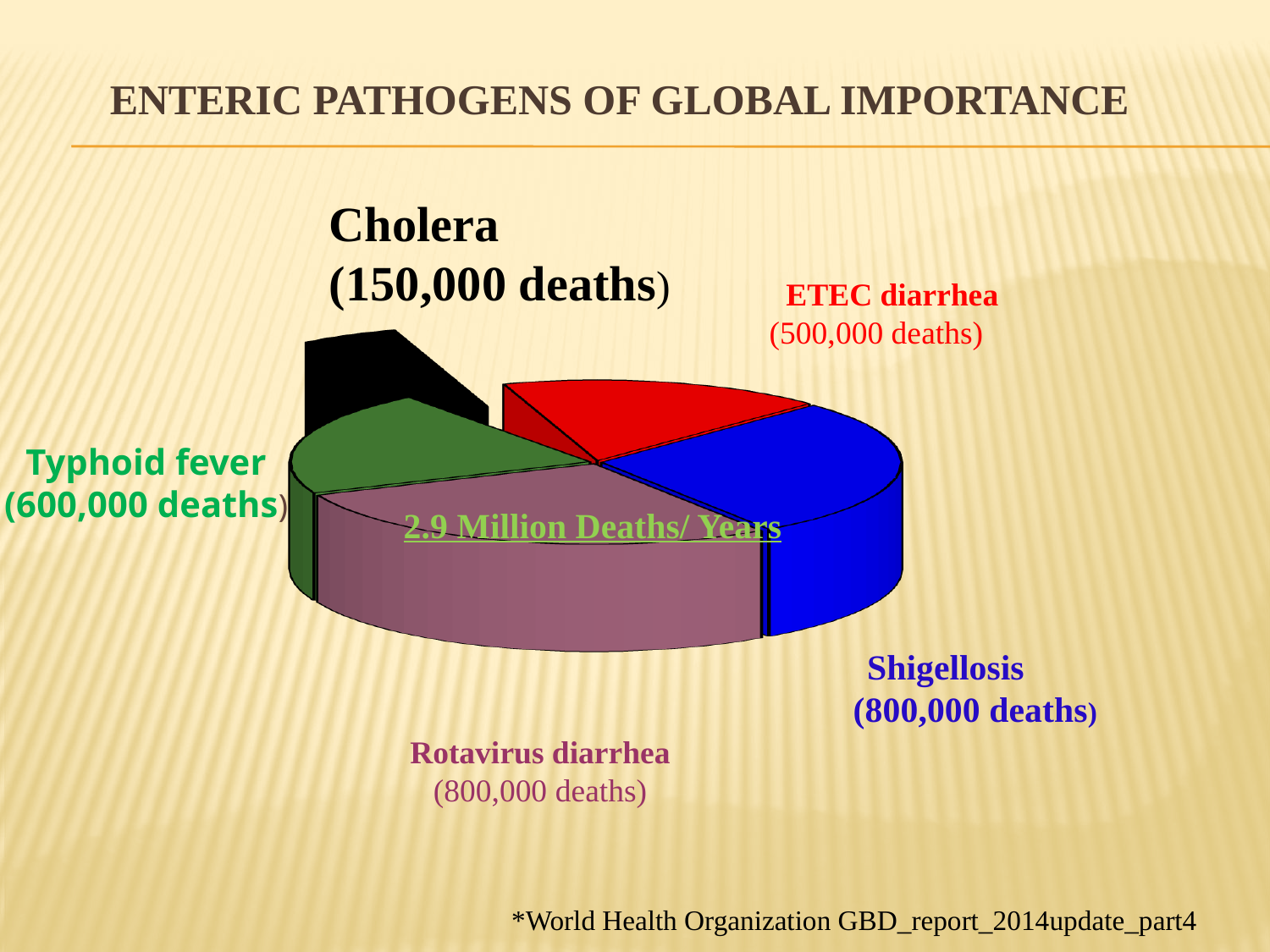
How many deaths are attributed to Typhoid fever? 600,000 deaths What kind of chart is shown on the slide? pie chart How many deaths are attributed to ETEC diarrhea? 500,000 deaths Which pathogen has the fewest deaths in the chart? Cholera How many deaths are attributed to Shigellosis? 800,000 deaths Which has more deaths, Cholera or ETEC diarrhea? ETEC diarrhea What is the difference in deaths between Shigellosis and Cholera? 650,000 What is the title of the slide containing the chart? ENTERIC PATHOGENS OF GLOBAL IMPORTANCE What is the difference in deaths between Typhoid fever and ETEC diarrhea? 100,000 How many pathogens (slices) are shown in the pie chart? 5 How many deaths are attributed to Cholera in the chart? 150,000 deaths What total figure is written in the centre of the pie chart? 2.9 Million Deaths/ Years